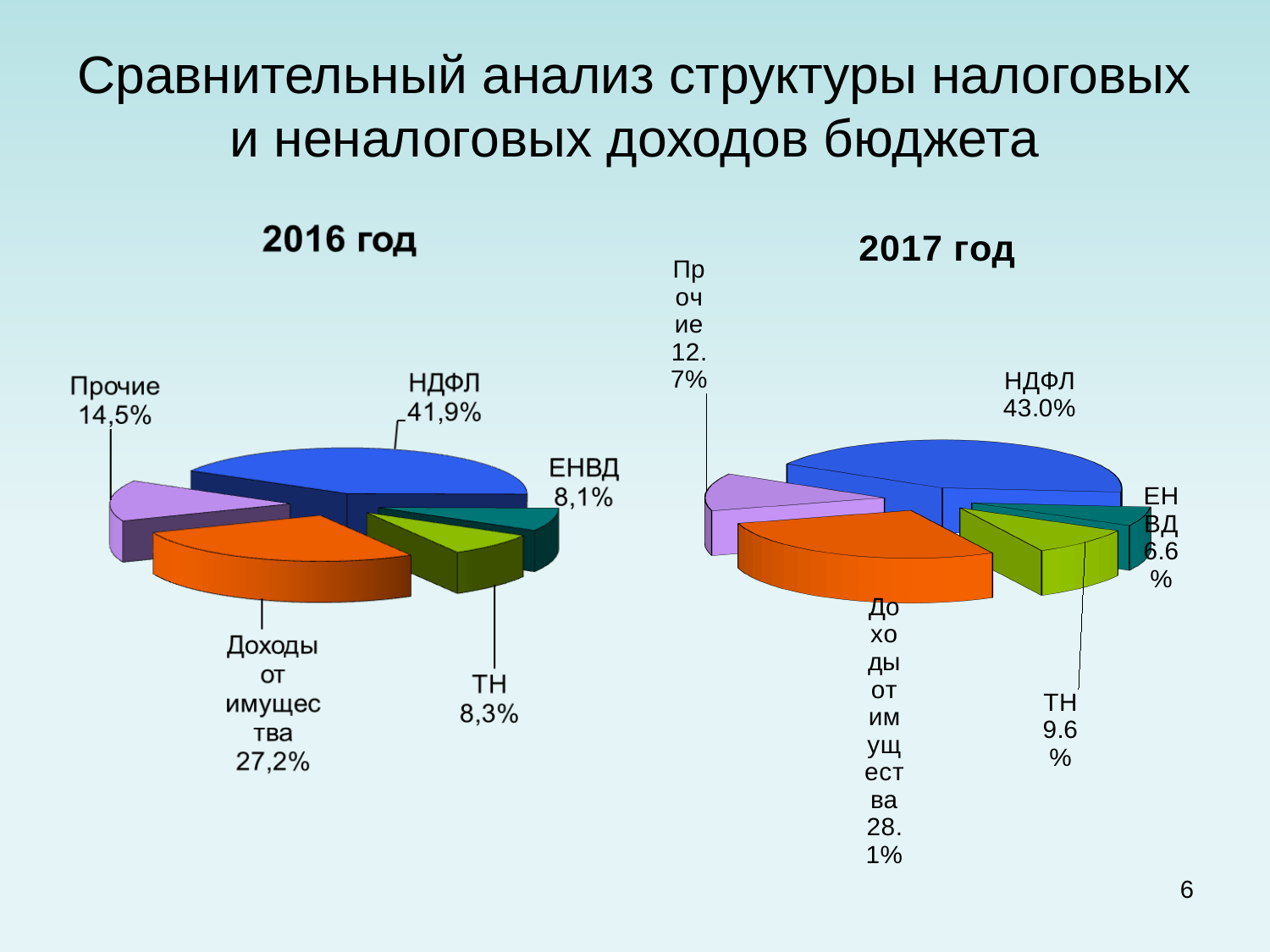
In the 2016 год chart, what is the value for Доходы от имущества? 27,2% In the 2016 год chart, which is larger, Прочие or ЕНВД? Прочие In the 2017 год chart, what is the difference in percentage points between НДФЛ and Доходы от имущества? 14.9 In the 2016 год chart, what share does НДФЛ have? 41,9% What type of chart is used for 2016 год? Pie chart In the 2017 год chart, which category has the smallest slice? ЕНВД How many categories does the 2017 год chart show? 5 In the 2017 год chart, what share does Прочие have? 12.7% In the 2017 год chart, what is the value for ТН? 9.6% In the 2017 год chart, which category has the largest slice? НДФЛ In the 2016 год chart, which category has the largest share? НДФЛ In the 2016 год chart, what share of the pie does ЕНВД represent? 8,1%